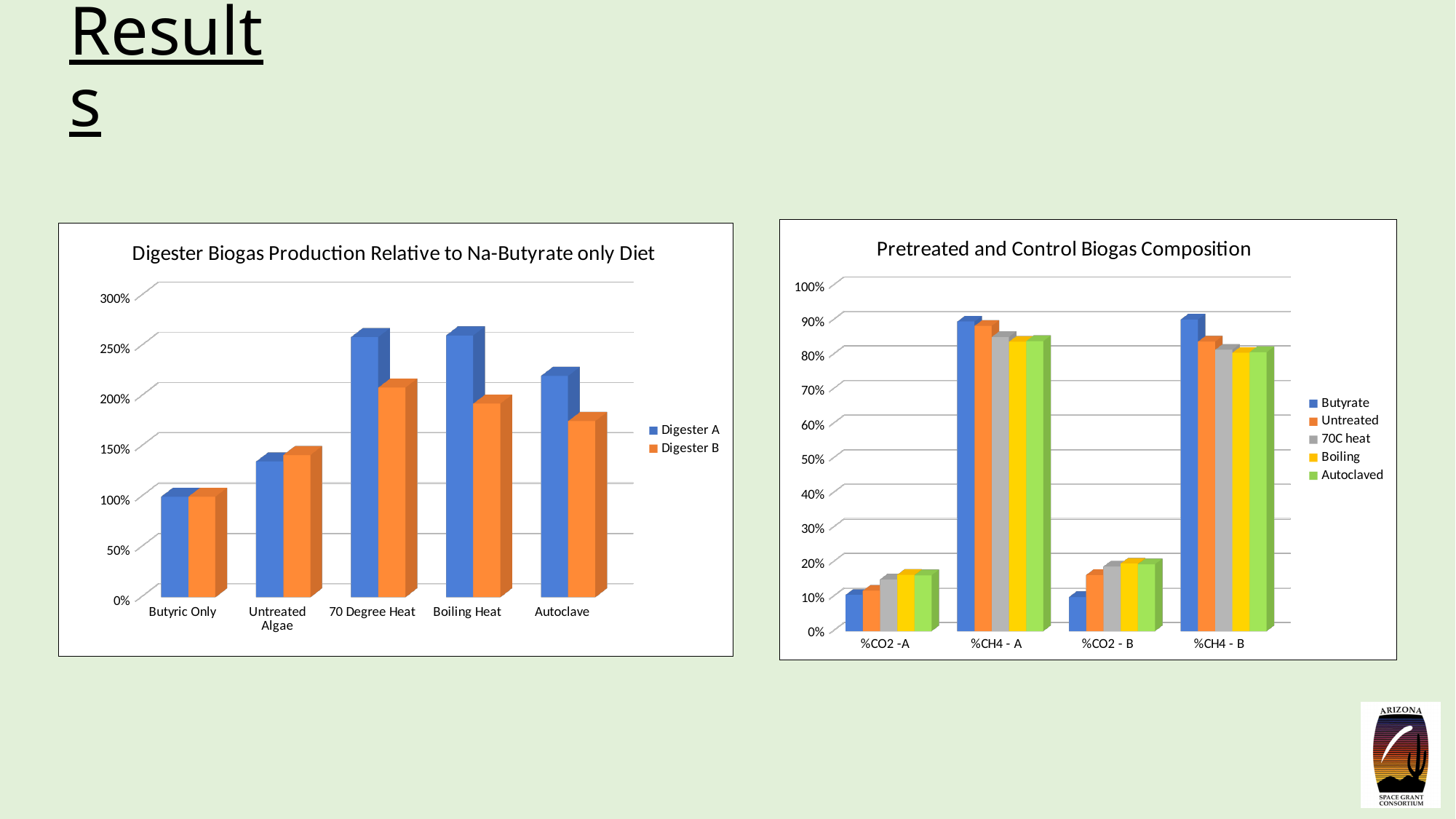
What kind of chart is the 'Digester Biogas Production Relative to Na-Butyrate only Diet' chart? bar chart How many categories are shown on the x axis of the 'Digester Biogas Production Relative to Na-Butyrate only Diet' chart? 5 In the 'Pretreated and Control Biogas Composition' chart, is the Butyrate value for %CH4 - A greater or less than 80%? greater How many categories are shown on the x axis of the 'Pretreated and Control Biogas Composition' chart? 4 How many series does the legend of the 'Pretreated and Control Biogas Composition' chart list? 5 In the 'Digester Biogas Production Relative to Na-Butyrate only Diet' chart, which is larger for Autoclave: Digester A or Digester B? Digester A In the 'Digester Biogas Production Relative to Na-Butyrate only Diet' chart, is the Digester A value for 70 Degree Heat greater or less than 200%? greater In the 'Pretreated and Control Biogas Composition' chart, which series has the lowest value for %CO2 - B? Butyrate How many series does the legend of the 'Digester Biogas Production Relative to Na-Butyrate only Diet' chart list? 2 In the 'Digester Biogas Production Relative to Na-Butyrate only Diet' chart, which category has the highest Digester B value? 70 Degree Heat In the 'Digester Biogas Production Relative to Na-Butyrate only Diet' chart, which category has the lowest Digester A value? Butyric Only In the 'Digester Biogas Production Relative to Na-Butyrate only Diet' chart, is the Digester B value for Autoclave greater or less than 200%? less